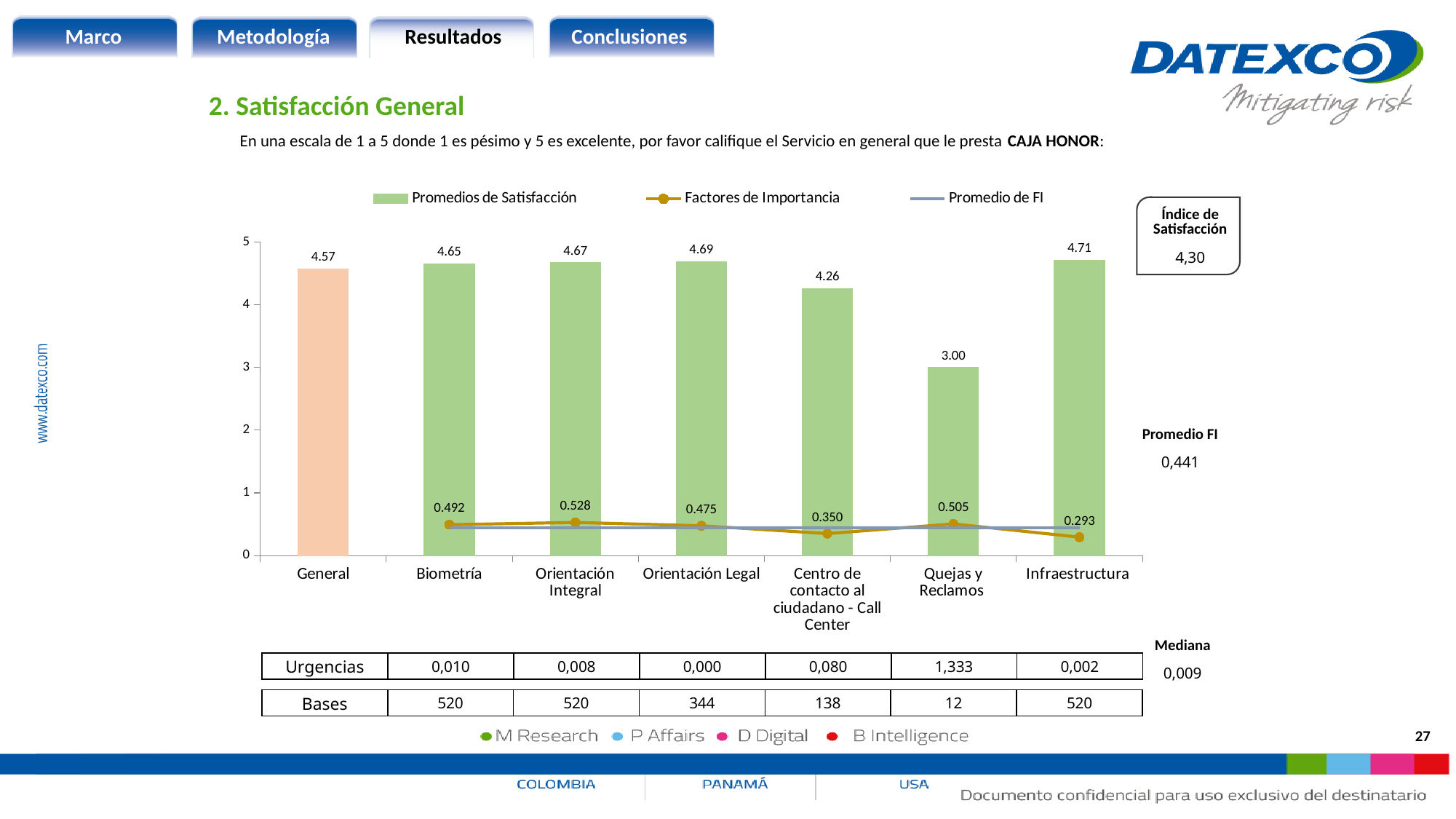
What is the Promedios de Satisfacción value for Biometría? 4.65 Which has a higher Promedios de Satisfacción value, General or Centro de contacto al ciudadano - Call Center? General Which category has the lowest Promedios de Satisfacción bar? Quejas y Reclamos How many categories are shown on the x axis of the chart? 7 Which category has the lowest Factores de Importancia value? Infraestructura What is the difference between the Promedios de Satisfacción values for Infraestructura and Quejas y Reclamos? 1.71 Is the Promedios de Satisfacción value for Centro de contacto al ciudadano - Call Center greater or less than 4? greater How many series does the chart legend list? 3 What is the Factores de Importancia value for Orientación Integral? 0.528 What type of chart is used to show the Promedios de Satisfacción series? Bar chart What is the Promedios de Satisfacción value for Quejas y Reclamos? 3.00 Which category has the highest Promedios de Satisfacción bar? Infraestructura